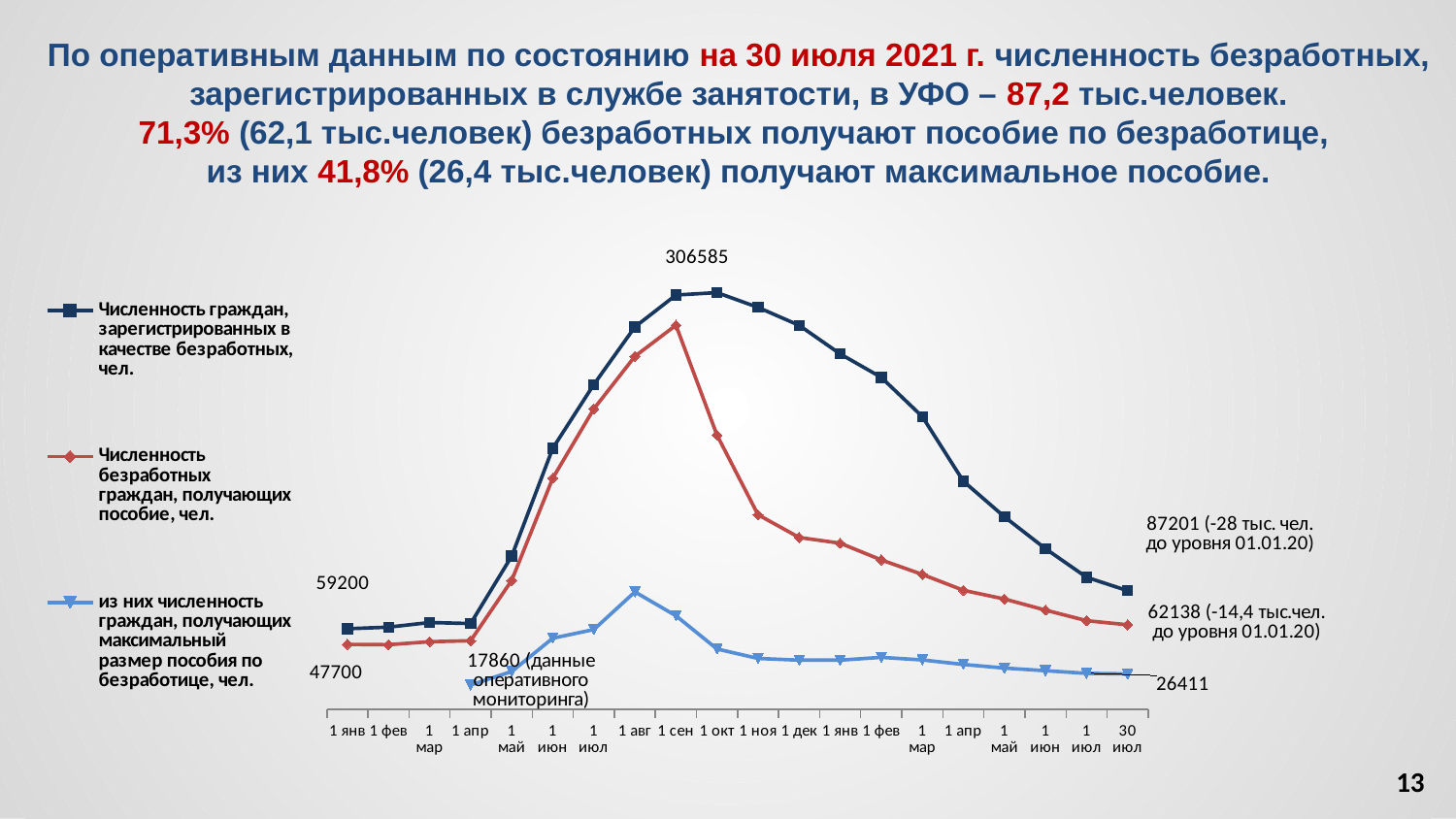
What is the highest value labelled for the series 'Численность граждан, зарегистрированных в качестве безработных'? 306585 What kind of chart is shown on the slide? line chart What is the value of the series 'Численность граждан, зарегистрированных в качестве безработных' at 30 июл? 87201 How many series does the legend list? 3 What is the difference between the registered unemployed (87201) and those receiving benefits (62138) at 30 июл? 25063 What is the value of the series 'Численность граждан, зарегистрированных в качестве безработных' at the first 1 янв? 59200 What is the difference between the peak value 306585 and the value 87201 at 30 июл for the registered unemployed series? 219384 Does the series 'Численность граждан, зарегистрированных в качестве безработных' rise or fall from 1 окт to 30 июл? fall What is the value of the series 'Численность безработных граждан, получающих пособие' at 30 июл? 62138 Which is larger at 30 июл: the number receiving benefits (62138) or the number receiving the maximum benefit (26411)? the number receiving benefits (62138) How many points are plotted along the x axis? 20